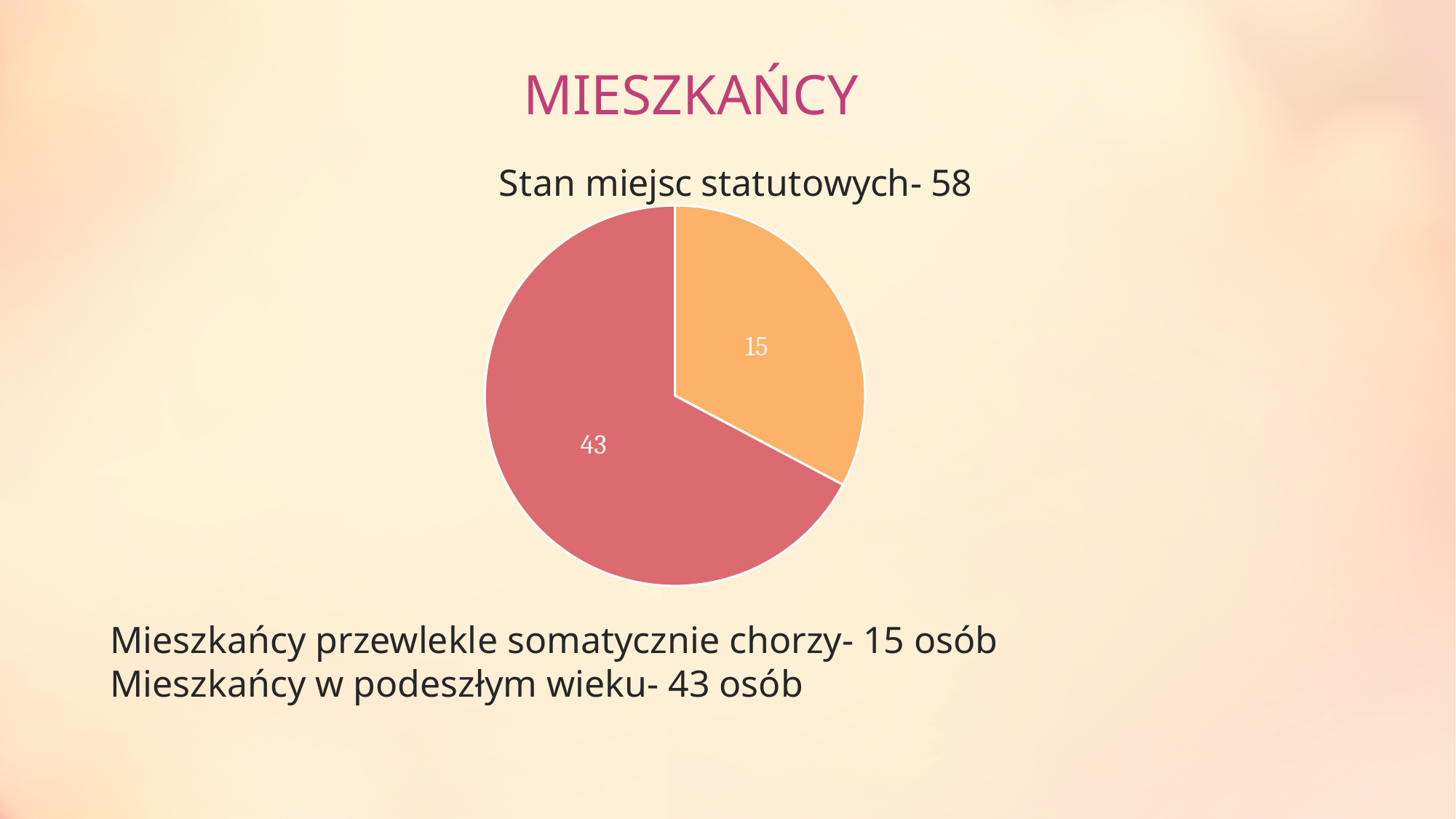
What is the difference between the two slice values in the pie chart? 28 What is the value shown on the orange slice of the pie chart? 15 What is the total of the two slices in the pie chart? 58 According to the slide text, how many residents are 'w podeszłym wieku' (elderly)? 43 osób Which slice of the pie chart is the largest? 43 How many slices does the pie chart have? 2 What is the title shown above the pie chart? Stan miejsc statutowych- 58 What kind of chart is shown on the slide? pie chart What is the value shown on the red slice of the pie chart? 43 Which slice of the pie chart is the smallest? 15 Which is larger in the pie chart: the red slice or the orange slice? the red slice